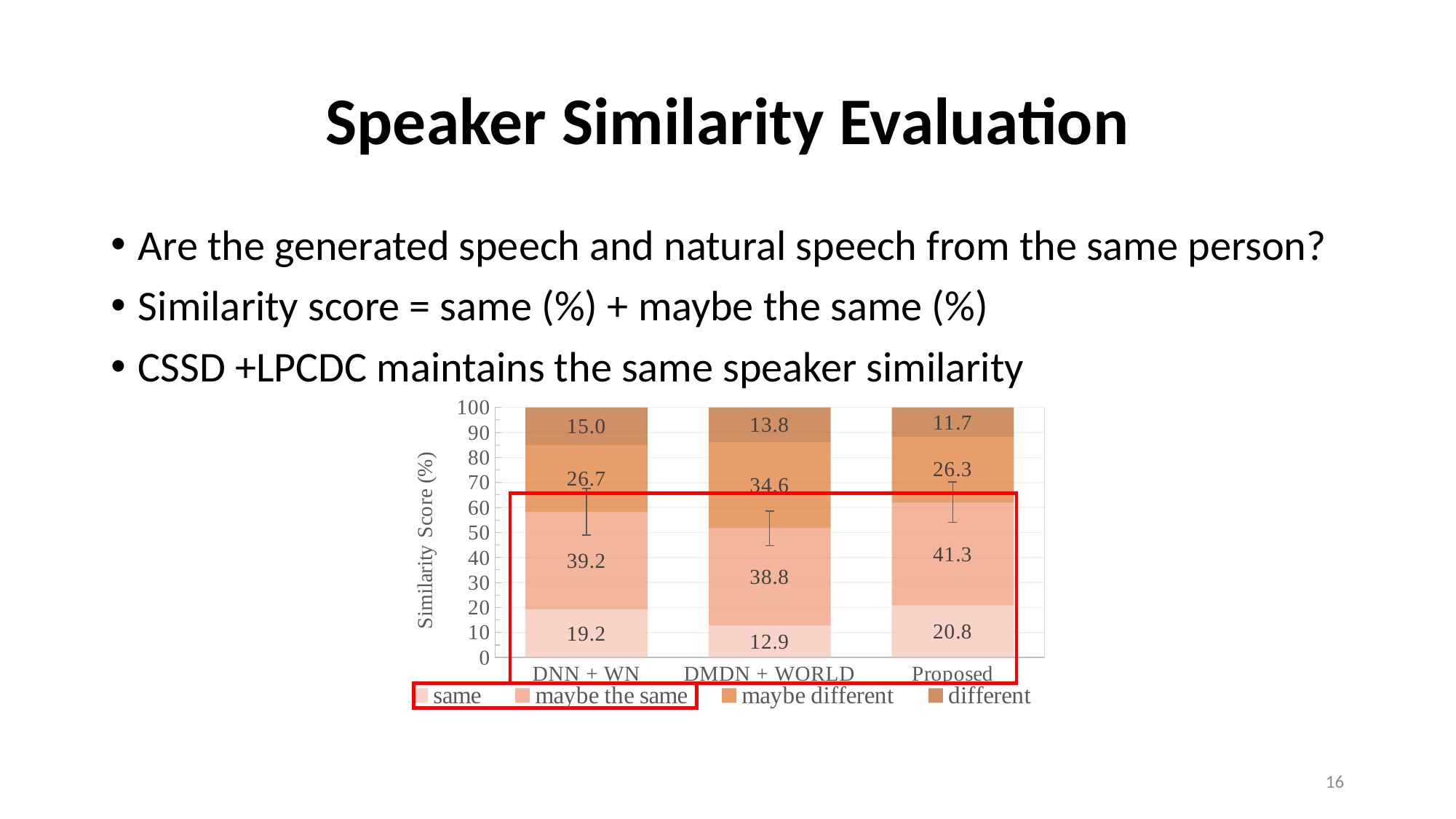
What is the 'different' percentage for DNN + WN? 15.0 How many series does the legend list? 4 Which system has the lowest 'different' percentage? Proposed Which system has the highest 'same' percentage? Proposed What kind of chart is shown on the slide? stacked bar chart What is the difference between the 'same' percentages of Proposed and DMDN + WORLD? 7.9 What is the similarity score (same + maybe the same) for DNN + WN? 58.4 What is the 'maybe different' percentage for DMDN + WORLD? 34.6 What is the 'same' percentage for DMDN + WORLD? 12.9 How many systems (categories) are compared on the x axis? 3 What is the 'maybe the same' percentage for the Proposed system? 41.3 Which is larger, the 'maybe different' value for DNN + WN or for DMDN + WORLD? DMDN + WORLD